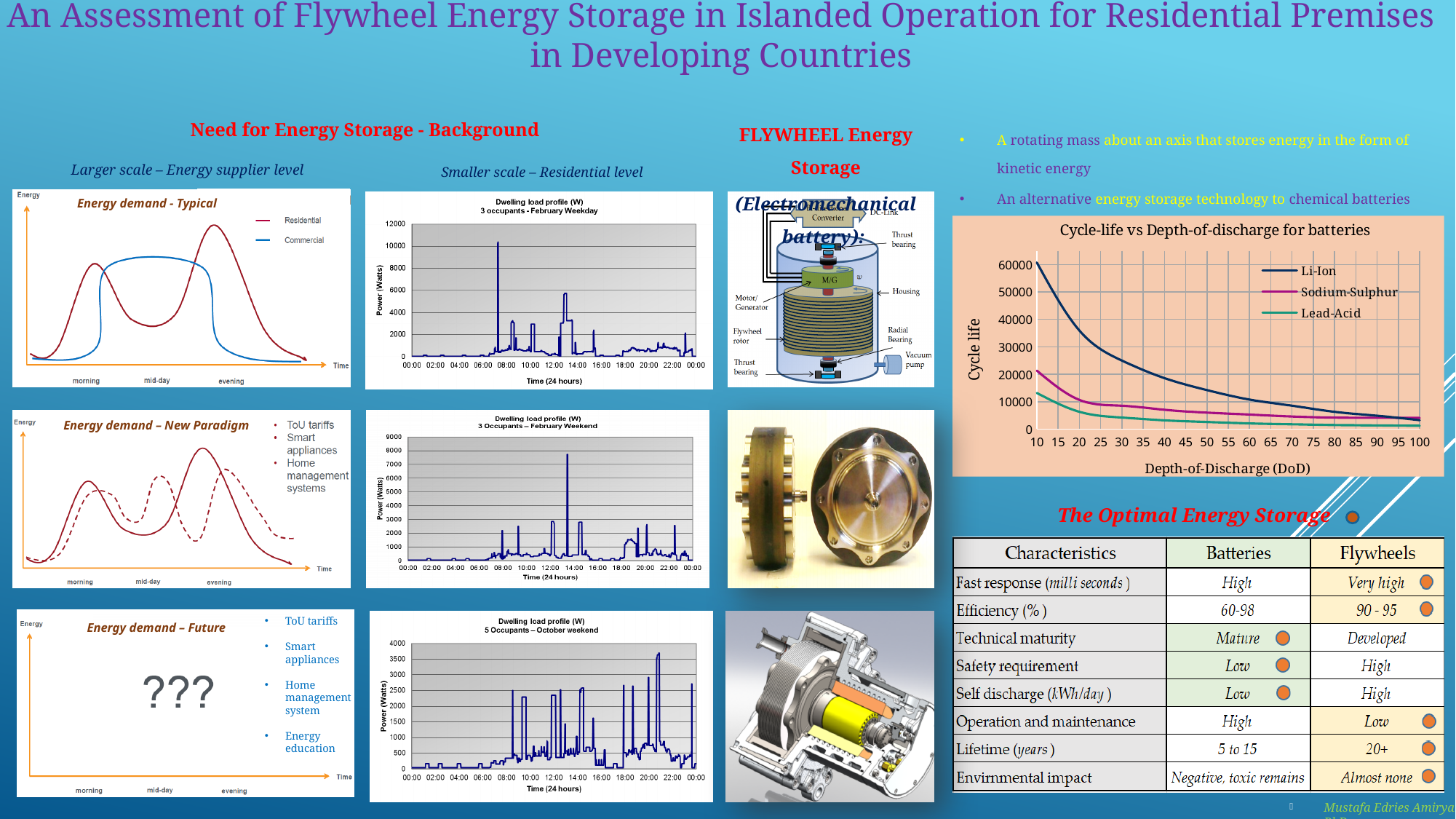
What kind of chart is the 'Cycle-life vs Depth-of-discharge for batteries' chart? line chart In the 'Cycle-life vs Depth-of-discharge for batteries' chart, which battery type has the lowest cycle life at 10% depth-of-discharge? Lead-Acid In the 'Cycle-life vs Depth-of-discharge for batteries' chart, which battery type has the highest cycle life at 10% depth-of-discharge? Li-Ion In the 'Energy demand - Typical' chart, how many series does the legend list? 2 In the 'Cycle-life vs Depth-of-discharge for batteries' chart, does the Li-Ion cycle life rise or fall as depth-of-discharge increases? fall In the 'Cycle-life vs Depth-of-discharge for batteries' chart, how many series does the legend list? 3 In the 'Dwelling load profile (W) 3 occupants - February Weekday' chart, is the highest peak greater or less than 8000 watts? greater In the 'Cycle-life vs Depth-of-discharge for batteries' chart, is the Li-Ion cycle life at 10% depth-of-discharge greater or less than 50000? greater In the 'Cycle-life vs Depth-of-discharge for batteries' chart, at 50% depth-of-discharge, which has the larger cycle life: Li-Ion or Lead-Acid? Li-Ion In the 'Cycle-life vs Depth-of-discharge for batteries' chart, is the Lead-Acid cycle life at 10% depth-of-discharge greater or less than 20000? less What is the x-axis label of the 'Cycle-life vs Depth-of-discharge for batteries' chart? Depth-of-Discharge (DoD)